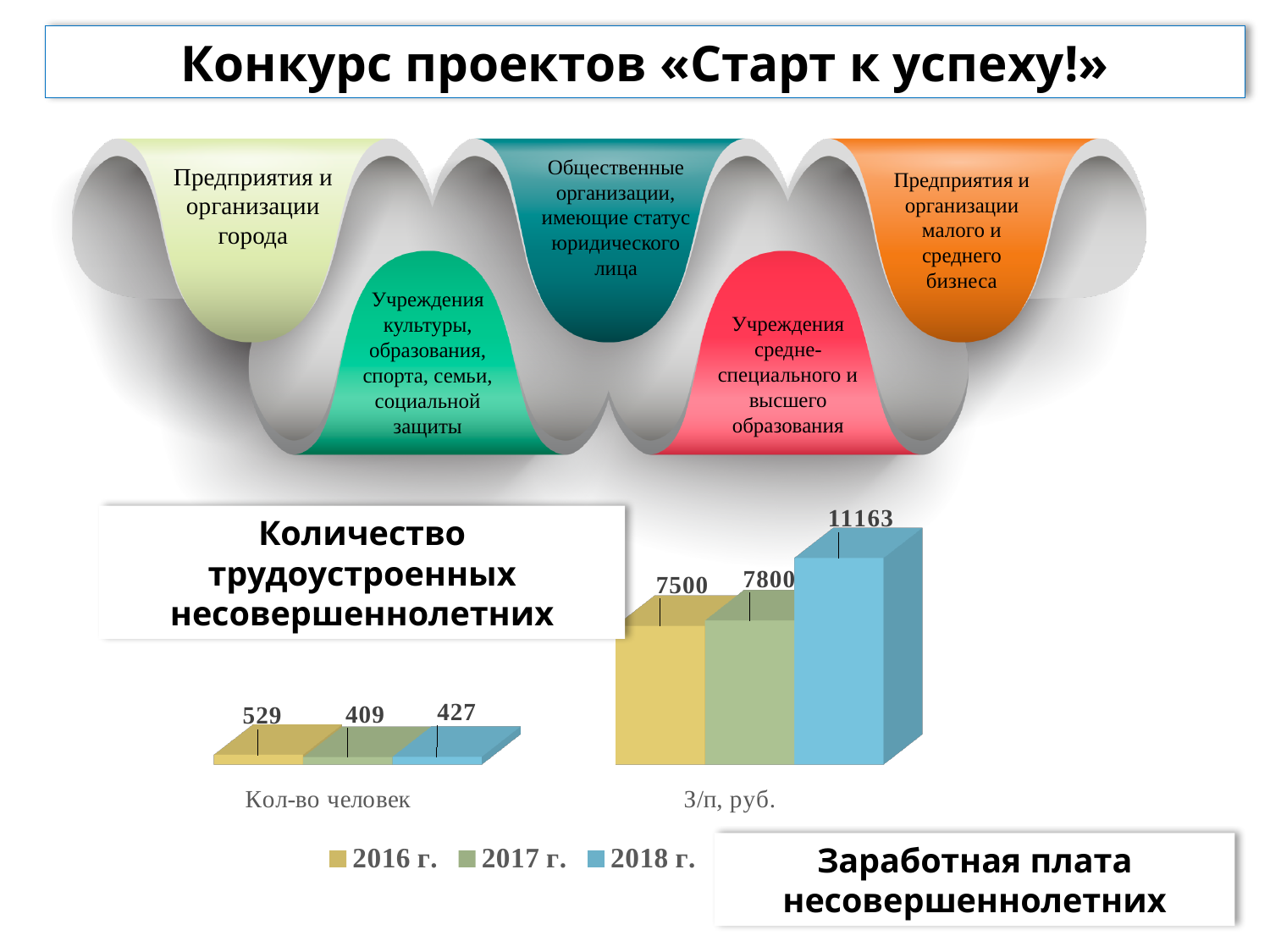
Which year has the highest value in the Кол-во человек category? 2016 г. What is the value for 2017 г. in the З/п, руб. category? 7800 In the Кол-во человек category, which is larger: the value for 2017 г. or 2018 г.? 2018 г. How many series does the legend list? 3 Which year has the highest value in the З/п, руб. category? 2018 г. Which colour represents 2018 г. in the legend? Blue What is the value for 2016 г. in the Кол-во человек category? 529 What is the difference between the 2018 г. and 2017 г. values in the З/п, руб. category? 3363 Which year has the lowest value in the Кол-во человек category? 2017 г. What kind of chart is shown on the slide? Bar chart What is the value for 2018 г. in the З/п, руб. category? 11163 What is the difference between the 2016 г. and 2017 г. values in the Кол-во человек category? 120